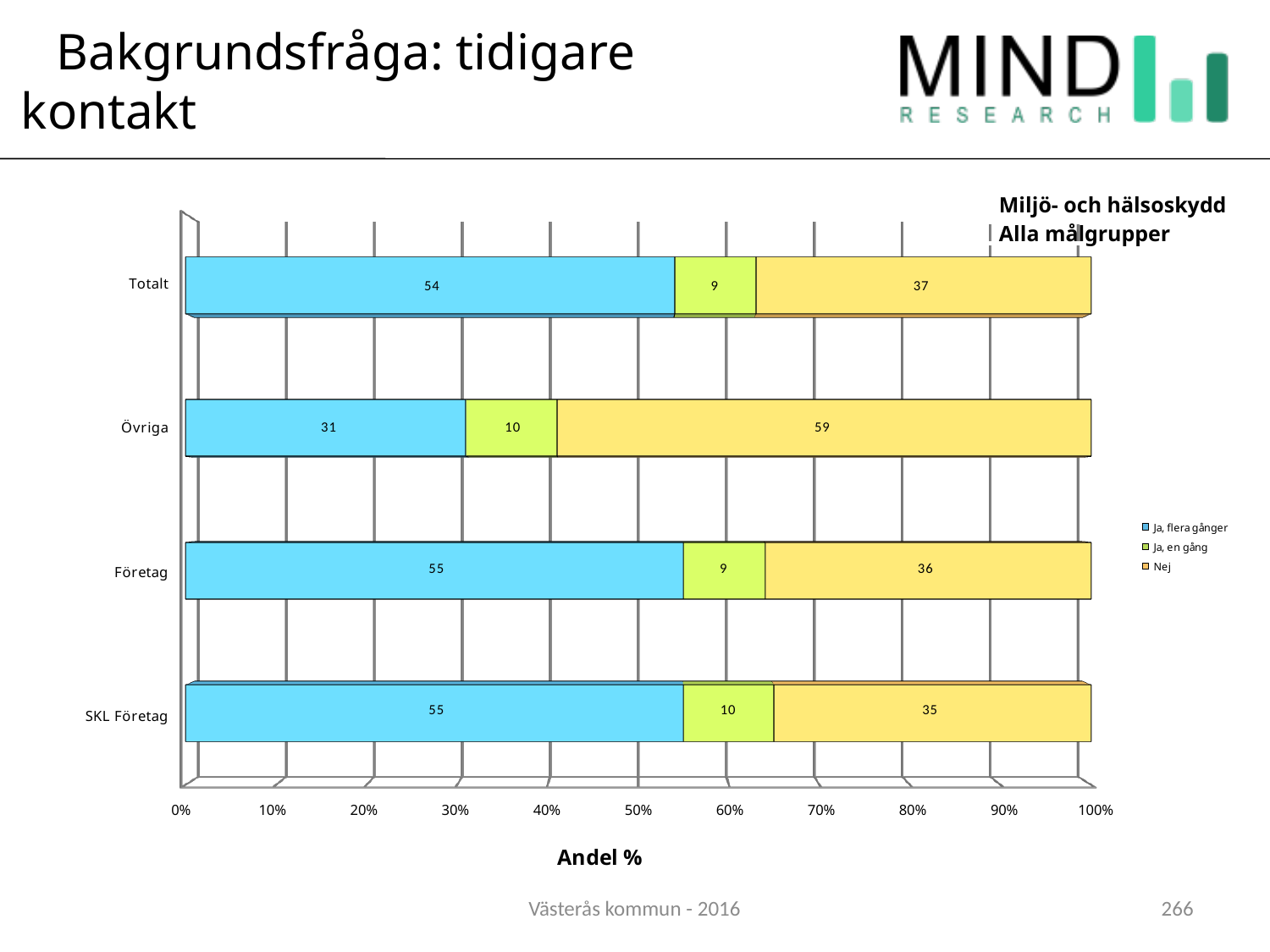
What kind of chart is shown on the slide? Stacked bar chart What is the value of "Nej" for Övriga? 59 Which is larger: the "Ja, flera gånger" value for Totalt or for Övriga? Totalt What is the value of "Ja, flera gånger" for Totalt? 54 Which category has the highest value for "Nej"? Övriga What is the difference between the "Nej" values for Övriga and Totalt? 22 Which category has the lowest value for "Ja, flera gånger"? Övriga What is the value of "Ja, en gång" for SKL Företag? 10 How many series does the legend list? 3 What is the label of the x axis? Andel % What is the value of "Nej" for Företag? 36 How many categories are shown on the y axis? 4